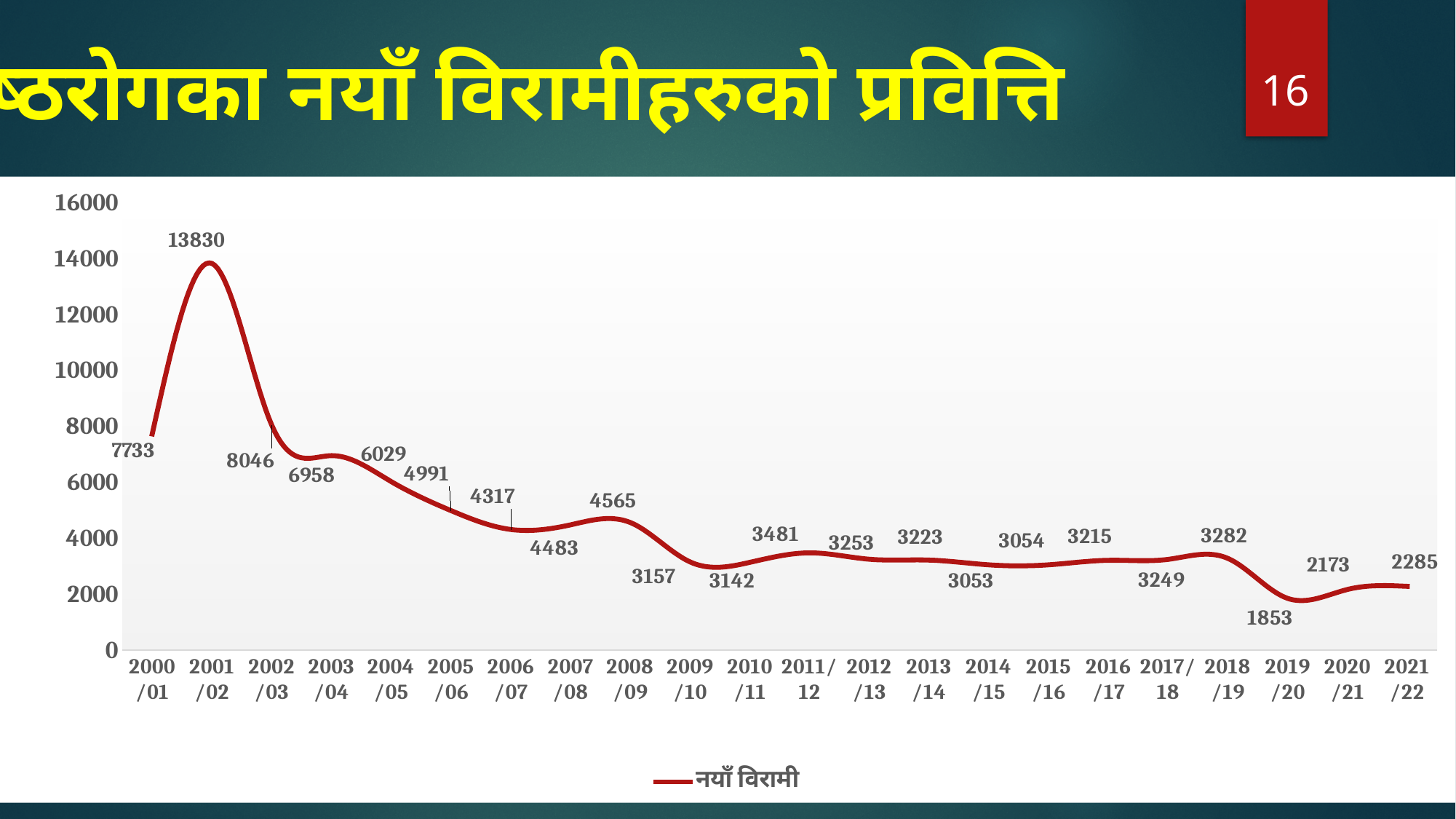
Does the value rise or fall from 2001/02 to 2006/07? fall Which is larger, the value for 2000/01 or the value for 2003/04? 2000/01 What is the difference between the values for 2001/02 and 2002/03? 5784 What type of chart is shown on the slide? line chart How many years are plotted on the x axis? 22 Which year has the lowest value? 2019/20 What is the value for 2001/02? 13830 Which year has the highest value? 2001/02 What is the value for 2019/20? 1853 Is the value for 2004/05 greater or less than 4000? greater How many series does the legend list? 1 What is the value for 2021/22? 2285